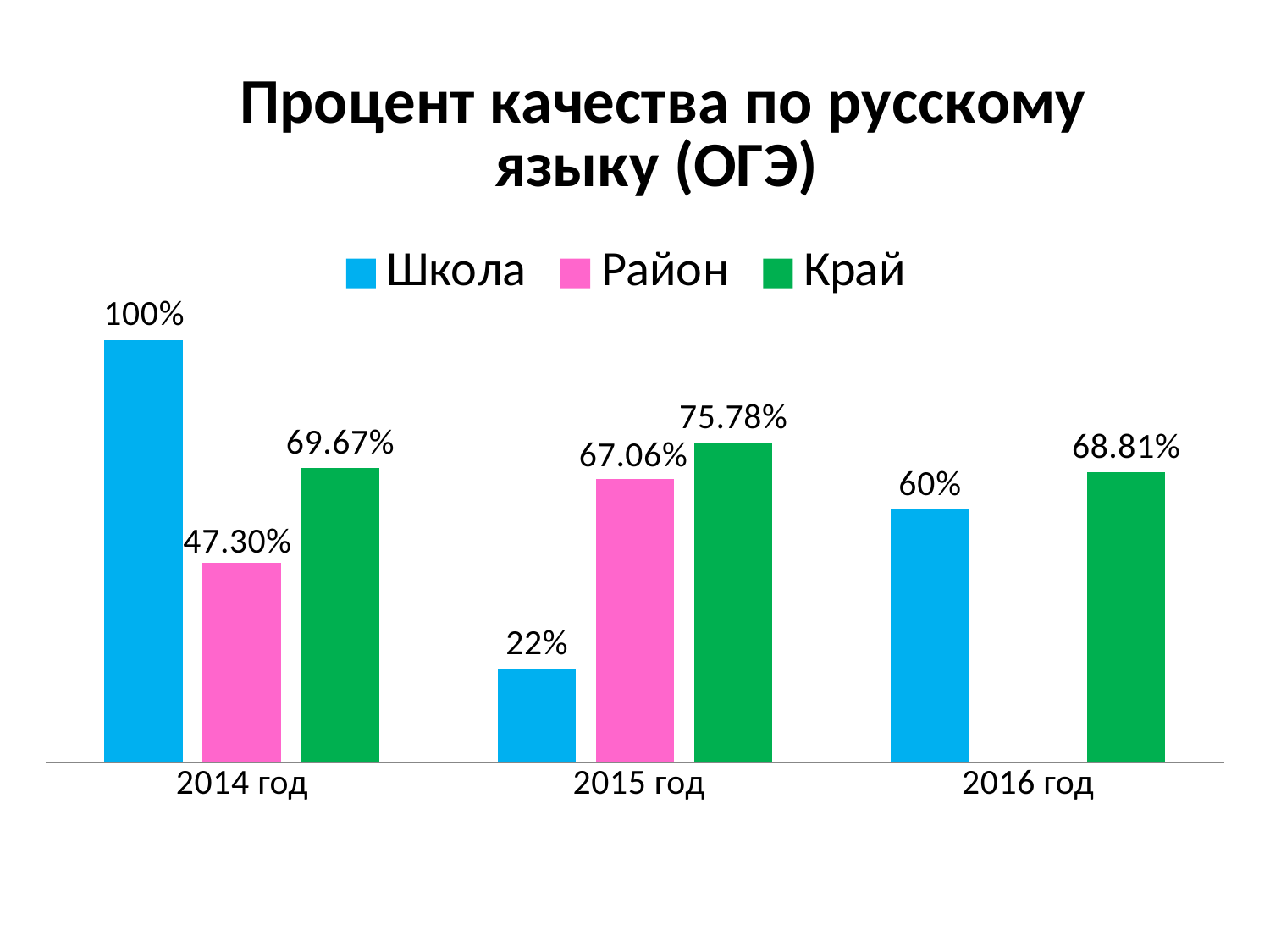
What kind of chart is this? Bar chart What is the value for Район in 2015 год? 67.06% How many year categories are shown on the x axis? 3 What is the value for Край in 2016 год? 68.81% In which year is the Школа value highest? 2014 год Which is larger in 2015 год, the Район value or the Край value? Край What is the difference between the Край and Район values in 2014 год? 22.37% How many series does the legend list? 3 What is the value for Школа in 2014 год? 100% What is the title of the chart? Процент качества по русскому языку (ОГЭ) In which year is the Школа value lowest? 2015 год What is the value for Школа in 2015 год? 22%